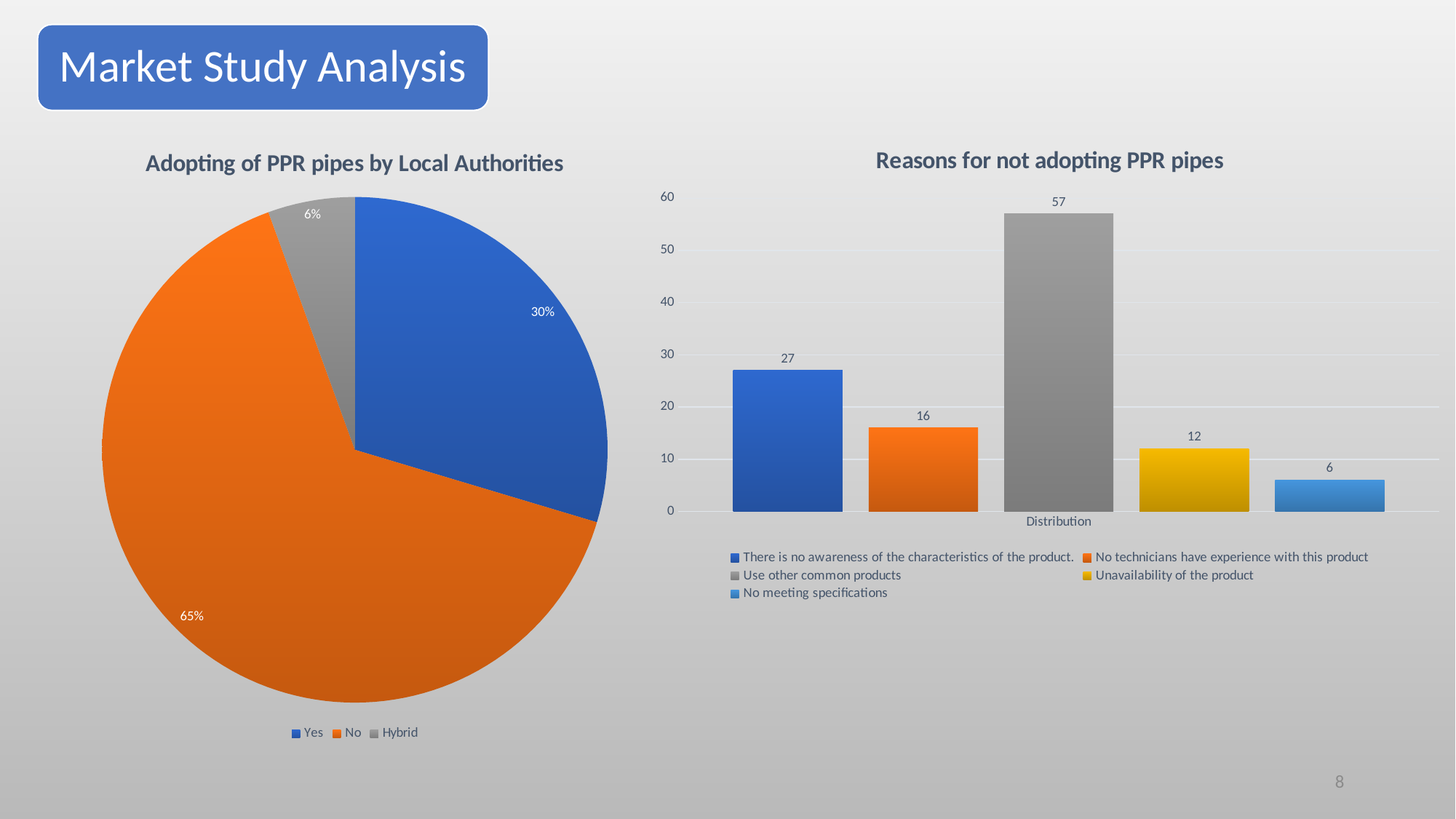
In the 'Adopting of PPR pipes by Local Authorities' chart, what share of the pie is 'Yes'? 30% What kind of chart is 'Adopting of PPR pipes by Local Authorities'? Pie chart How many series does the legend of the 'Reasons for not adopting PPR pipes' chart list? 5 In the 'Adopting of PPR pipes by Local Authorities' chart, what share of the pie is 'No'? 65% In the 'Reasons for not adopting PPR pipes' chart, which is larger: 'Unavailability of the product' or 'No technicians have experience with this product'? No technicians have experience with this product In the 'Adopting of PPR pipes by Local Authorities' chart, what share of the pie is 'Hybrid'? 6% In the 'Reasons for not adopting PPR pipes' chart, what is the value for 'No technicians have experience with this product'? 16 In the 'Reasons for not adopting PPR pipes' chart, what is the value for 'Use other common products'? 57 In the 'Adopting of PPR pipes by Local Authorities' chart, which category has the smallest slice? Hybrid In the 'Reasons for not adopting PPR pipes' chart, what is the difference between 'Use other common products' and 'There is no awareness of the characteristics of the product.'? 30 How many categories does the legend of the 'Adopting of PPR pipes by Local Authorities' chart list? 3 In the 'Reasons for not adopting PPR pipes' chart, which reason has the lowest value? No meeting specifications